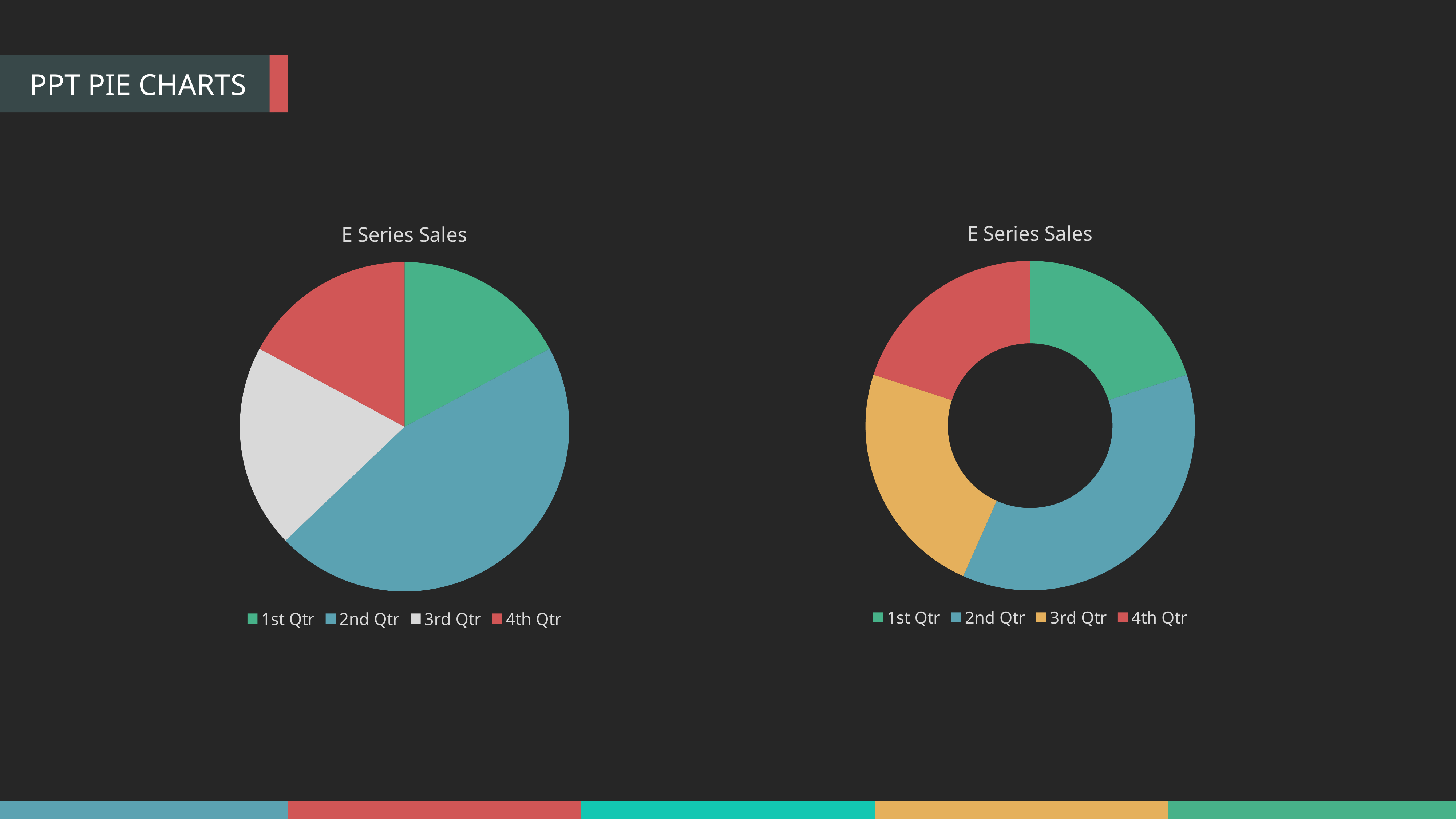
How many categories does the left pie chart show? 4 In the left pie chart, which quarter has the largest slice? 2nd Qtr In the right doughnut chart, what colour represents 3rd Qtr? Orange What type of chart is the chart on the right of the slide? Doughnut chart How many categories does the right doughnut chart show? 4 In the left pie chart, which is larger, the slice for 2nd Qtr or the slice for 3rd Qtr? 2nd Qtr In the right doughnut chart, which quarter has the largest segment? 2nd Qtr What type of chart is the chart on the left of the slide? Pie chart How many entries does the legend of the left pie chart list? 4 What is the title of the chart on the left of the slide? E Series Sales In the right doughnut chart, which is larger, the segment for 3rd Qtr or the segment for 1st Qtr? 3rd Qtr